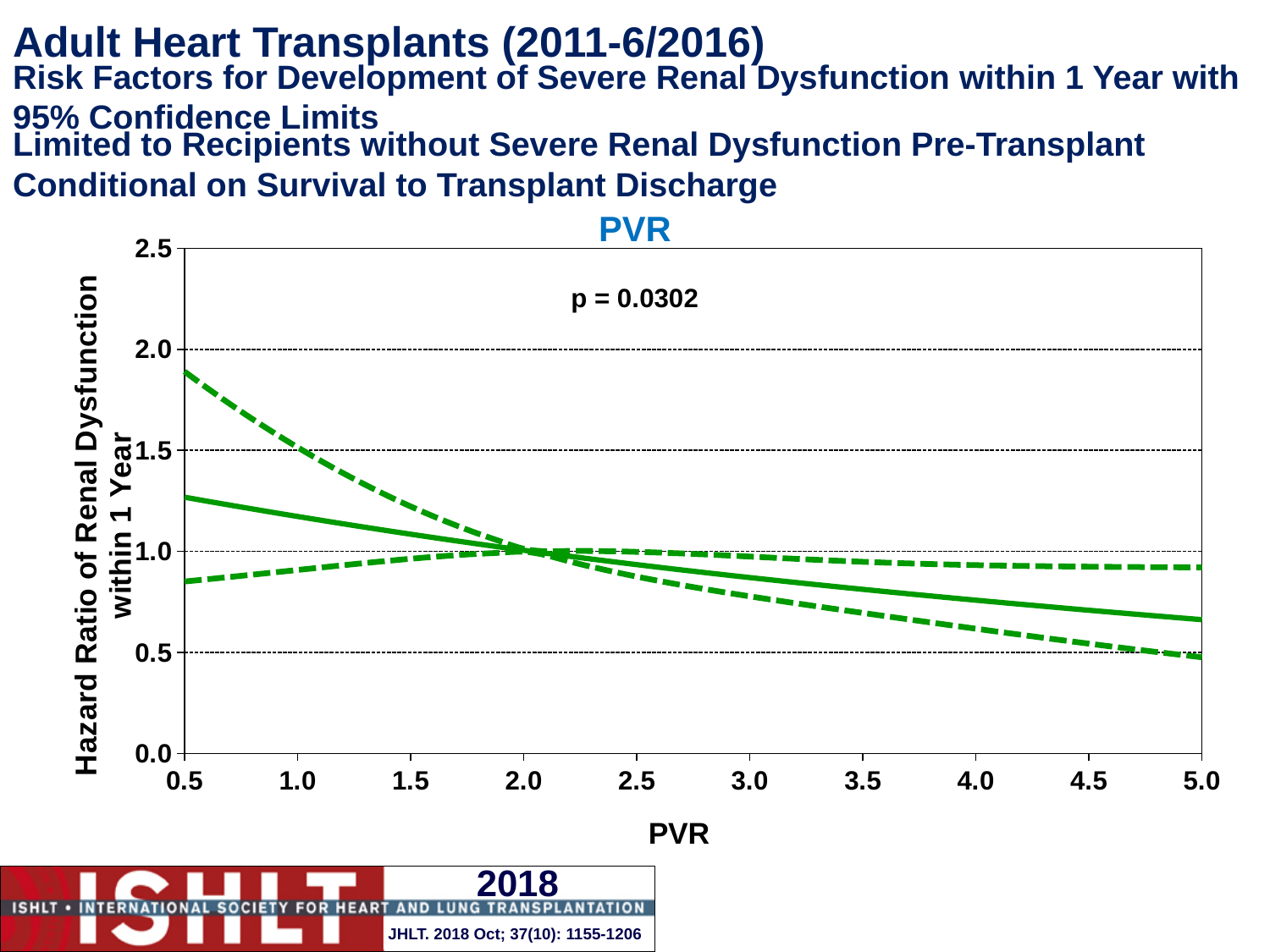
What is the title shown above the chart? PVR Is the upper confidence limit (upper dashed line) at PVR 0.5 greater or less than 2.0? less Is the upper confidence limit (upper dashed line) at PVR 0.5 greater or less than 1.5? greater What is the p-value printed on the PVR chart? p = 0.0302 How many lines are plotted on the PVR chart? 3 Is the hazard ratio on the solid line at PVR 5.0 greater or less than 1.0? less What is the label of the y-axis? Hazard Ratio of Renal Dysfunction within 1 Year Does the hazard ratio (solid line) rise or fall as PVR increases from 0.5 to 5.0? fall At what PVR value do the solid line and both dashed lines cross at a hazard ratio of 1.0? 2.0 What kind of chart is shown on the slide? line chart